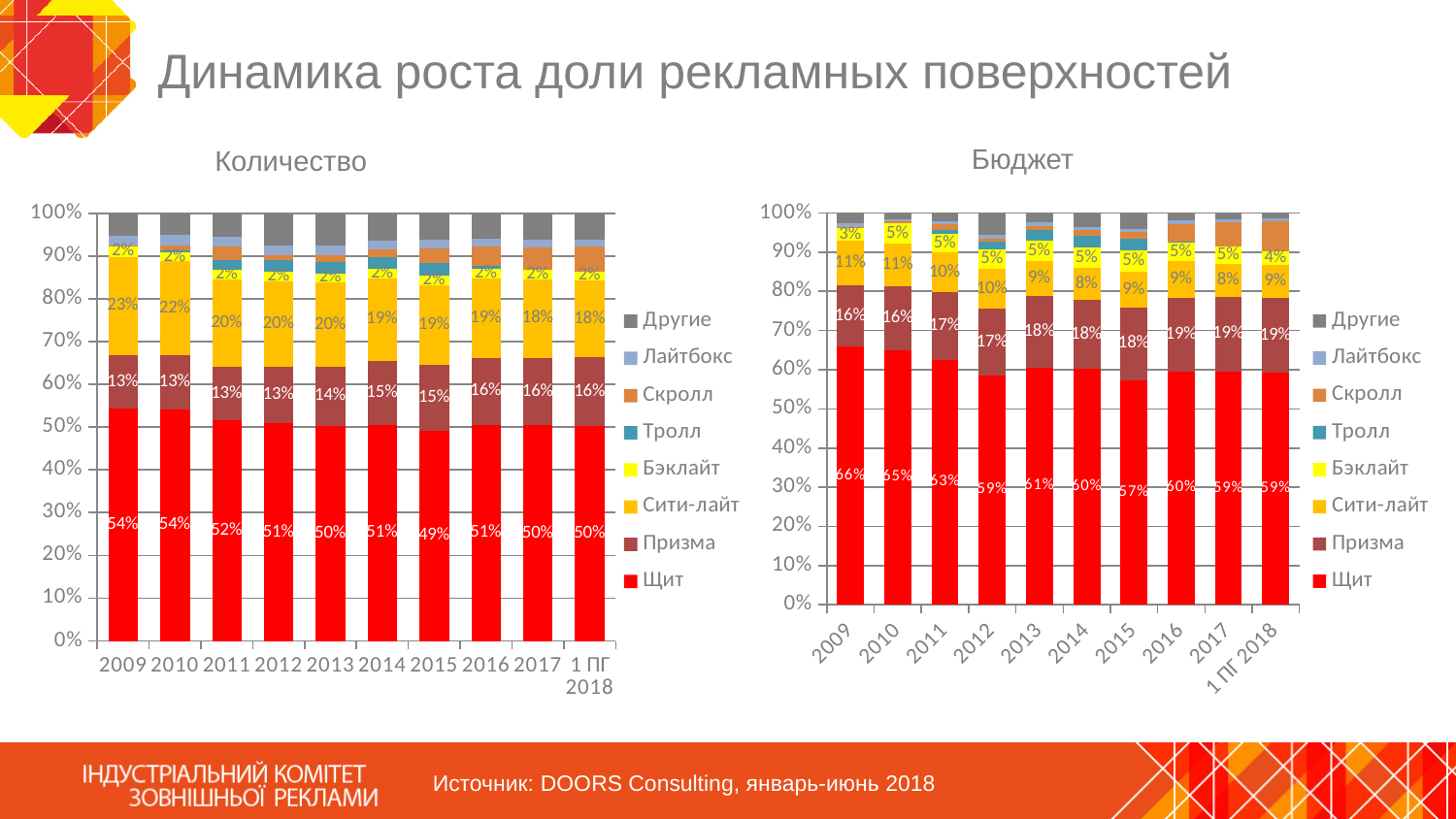
In the Бюджет chart, what is the value for Бэклайт in 2009? 3% How many series does the legend of the Количество chart list? 8 What kind of chart is the Бюджет chart? Stacked bar chart In the Бюджет chart, what is the value for Призма in 2013? 18% In the Количество chart, what is the difference between the Сити-лайт value in 2009 and in 1 ПГ 2018? 5% In the Количество chart, what is the value for Сити-лайт in 2011? 20% In the Количество chart, which year has the lowest value for Щит? 2015 In the Бюджет chart, what is the value for Щит in 2015? 57% How many years (categories) are shown on the x axis of the Бюджет chart? 10 In the Бюджет chart, which is larger: the Призма value in 2009 or in 2017? 2017 In the Количество chart, what is the value for Щит in 2009? 54% In the Бюджет chart, which year has the highest value for Щит? 2009